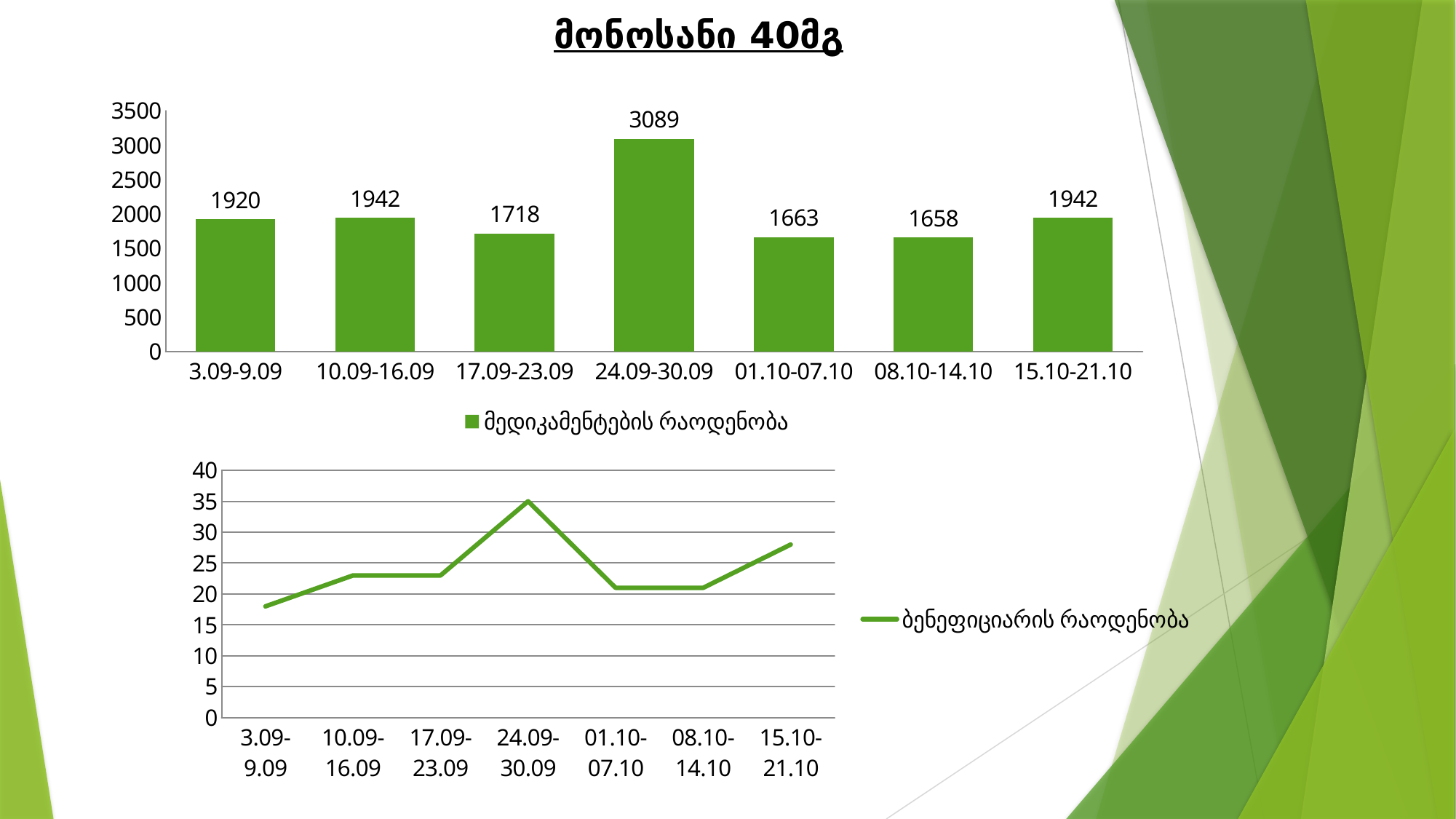
What kind of chart is the top chart on the slide? bar chart In the top bar chart, what is the value for 08.10-14.10? 1658 In the top bar chart, which category has the lowest value? 08.10-14.10 In the bottom line chart, is the value for 15.10-21.10 greater or less than 25? greater In the top bar chart, what is the difference between the values for 24.09-30.09 and 17.09-23.09? 1371 In the top bar chart, what is the value for 24.09-30.09? 3089 In the bottom line chart, which category has the highest value? 24.09-30.09 In the bottom line chart, is the value for 3.09-9.09 greater or less than 20? less In the top bar chart, which is larger: the value for 3.09-9.09 or the value for 01.10-07.10? 3.09-9.09 How many categories are shown in the top bar chart? 7 What kind of chart is the bottom chart on the slide? line chart In the top bar chart, which category has the highest value? 24.09-30.09